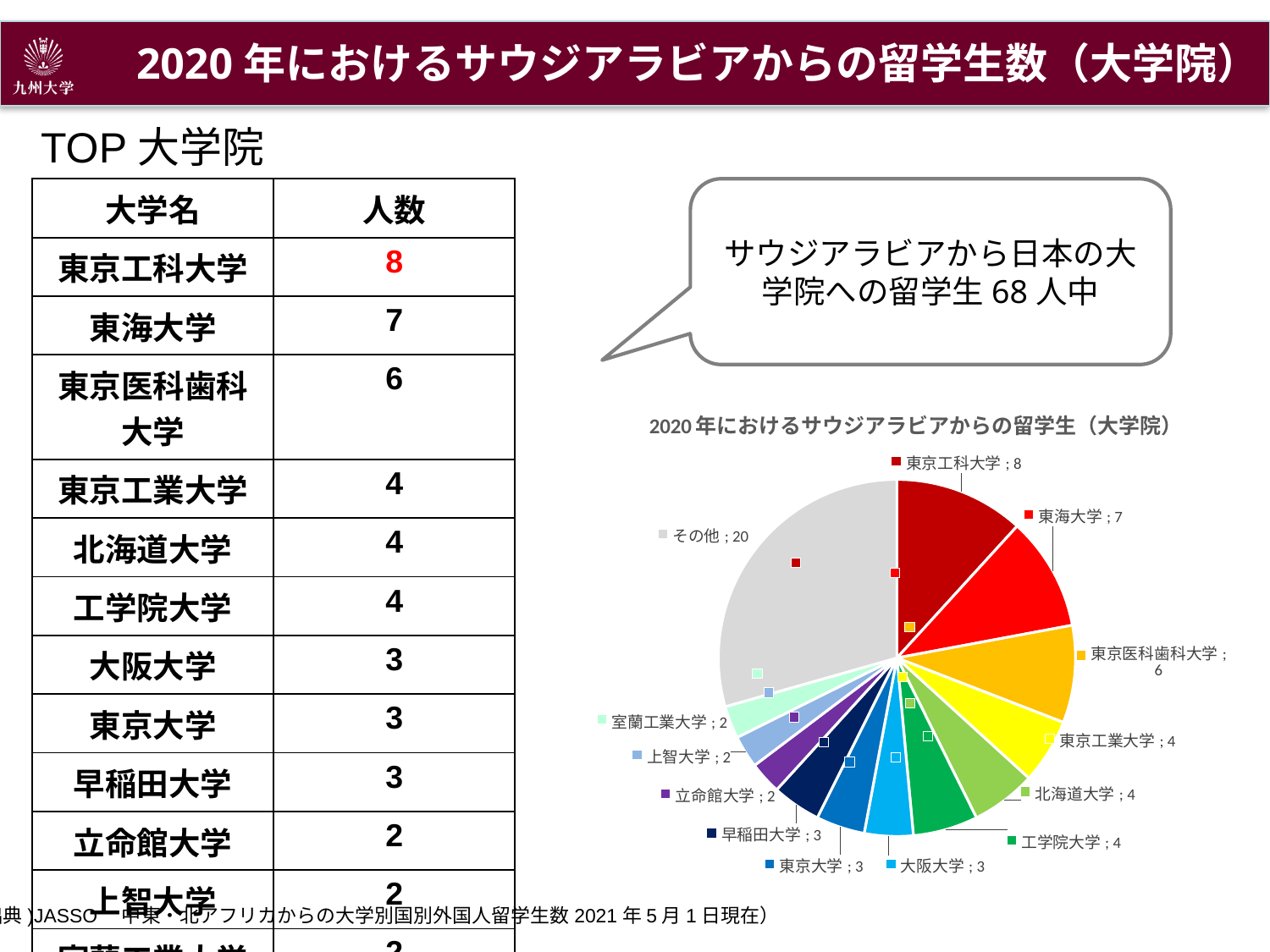
In the pie chart, what is the value for 東海大学? 7 In the pie chart, what is the value for その他? 20 In the pie chart, what is the value for 東京工科大学? 8 In the pie chart, what is the difference between the values for 東京工科大学 and 東海大学? 1 What is the title of the pie chart? 2020年におけるサウジアラビアからの留学生（大学院） In the pie chart, what is the difference between the values for その他 and 東京医科歯科大学? 14 How many slices does the pie chart have? 13 What kind of chart is shown on the slide? pie chart Which slice of the pie chart is the largest? その他 Among the named universities in the pie chart, which has the highest value? 東京工科大学 In the pie chart, which is larger, the value for 北海道大学 or the value for 大阪大学? 北海道大学 In the pie chart, what is the value for 東京医科歯科大学? 6